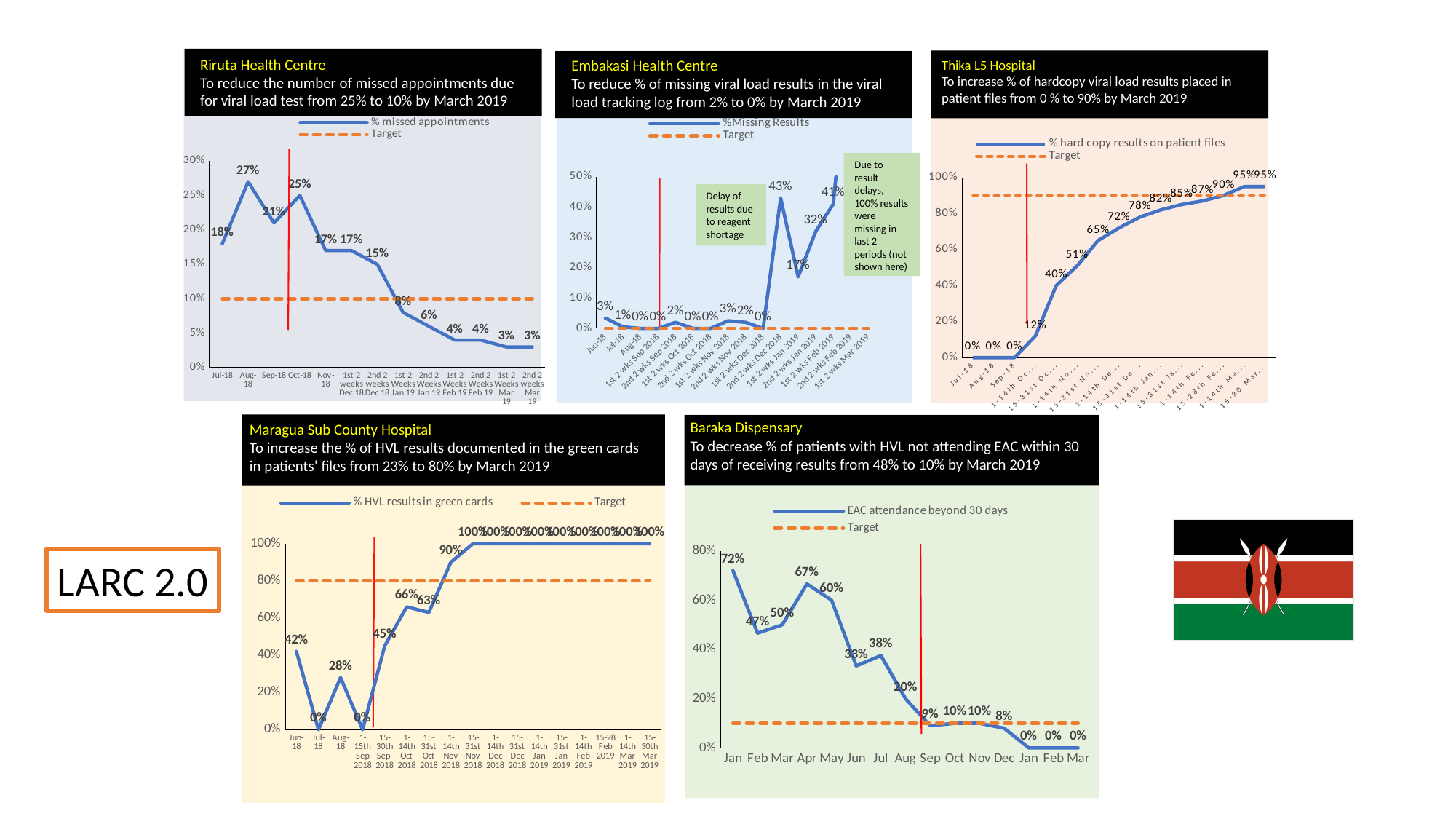
On the Embakasi Health Centre chart, what is the % missing results value for Jun-18? 3% On the Maragua Sub County Hospital chart, which is larger: the value for 1-14th Oct 2018 or the value for 15-31st Oct 2018? 1-14th Oct 2018 On the Riruta Health Centre chart, what is the difference between the Jul-18 value and the Aug-18 value? 9% On the Thika L5 Hospital chart, what is the % hard copy results on patient files value for 1-14th Dec? 72% On the Thika L5 Hospital chart, do the % hard copy results on patient files values generally rise or fall over time? rise On the Riruta Health Centre chart, what is the % missed appointments value for Aug-18? 27% On the Riruta Health Centre chart, which period has the highest % missed appointments? Aug-18 How many series does the legend list on the Baraka Dispensary chart? 2 On the Maragua Sub County Hospital chart, what is the % HVL results in green cards value for Jun-18? 42% On the Baraka Dispensary chart, which month has the highest EAC attendance beyond 30 days value? Jan On the Baraka Dispensary chart, what is the EAC attendance beyond 30 days value for Aug? 20% On the Embakasi Health Centre chart, what is the % missing results value for 2nd 2 wks Dec 2018? 43%